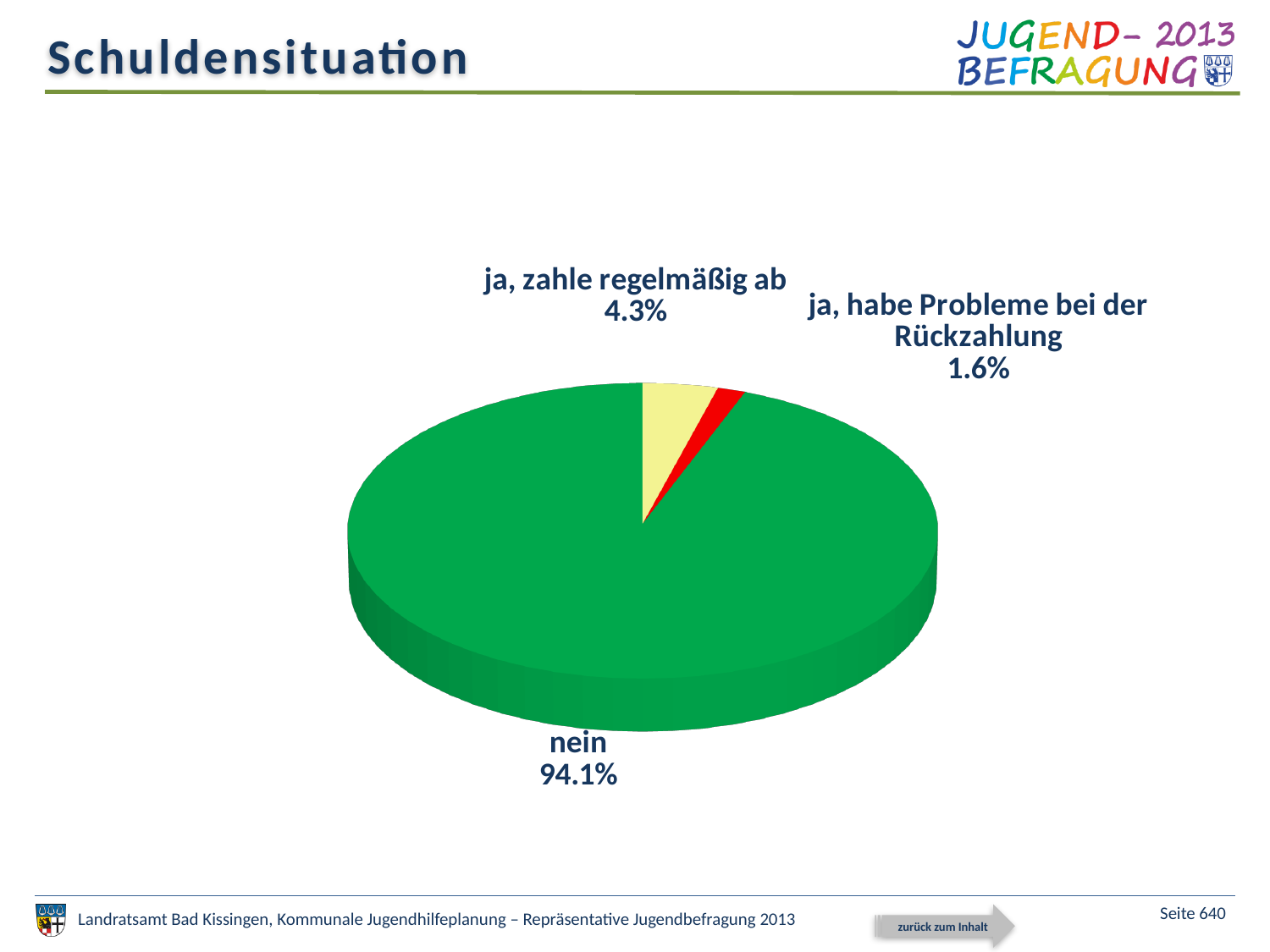
What percentage is shown for "ja, zahle regelmäßig ab"? 4.3% Which category has the smallest share of the pie? ja, habe Probleme bei der Rückzahlung What kind of chart is shown on the slide? pie chart What colour is the slice for "nein"? green How many slices does the pie chart have? 3 What percentage is shown for "nein"? 94.1% What is the difference in percentage points between "nein" and "ja, zahle regelmäßig ab"? 89.8 Which category has the largest share of the pie? nein Which is larger, the share for "ja, zahle regelmäßig ab" or the share for "ja, habe Probleme bei der Rückzahlung"? ja, zahle regelmäßig ab What percentage is shown for "ja, habe Probleme bei der Rückzahlung"? 1.6% What is the title of the slide containing the chart? Schuldensituation What is the difference in percentage points between "ja, zahle regelmäßig ab" and "ja, habe Probleme bei der Rückzahlung"? 2.7